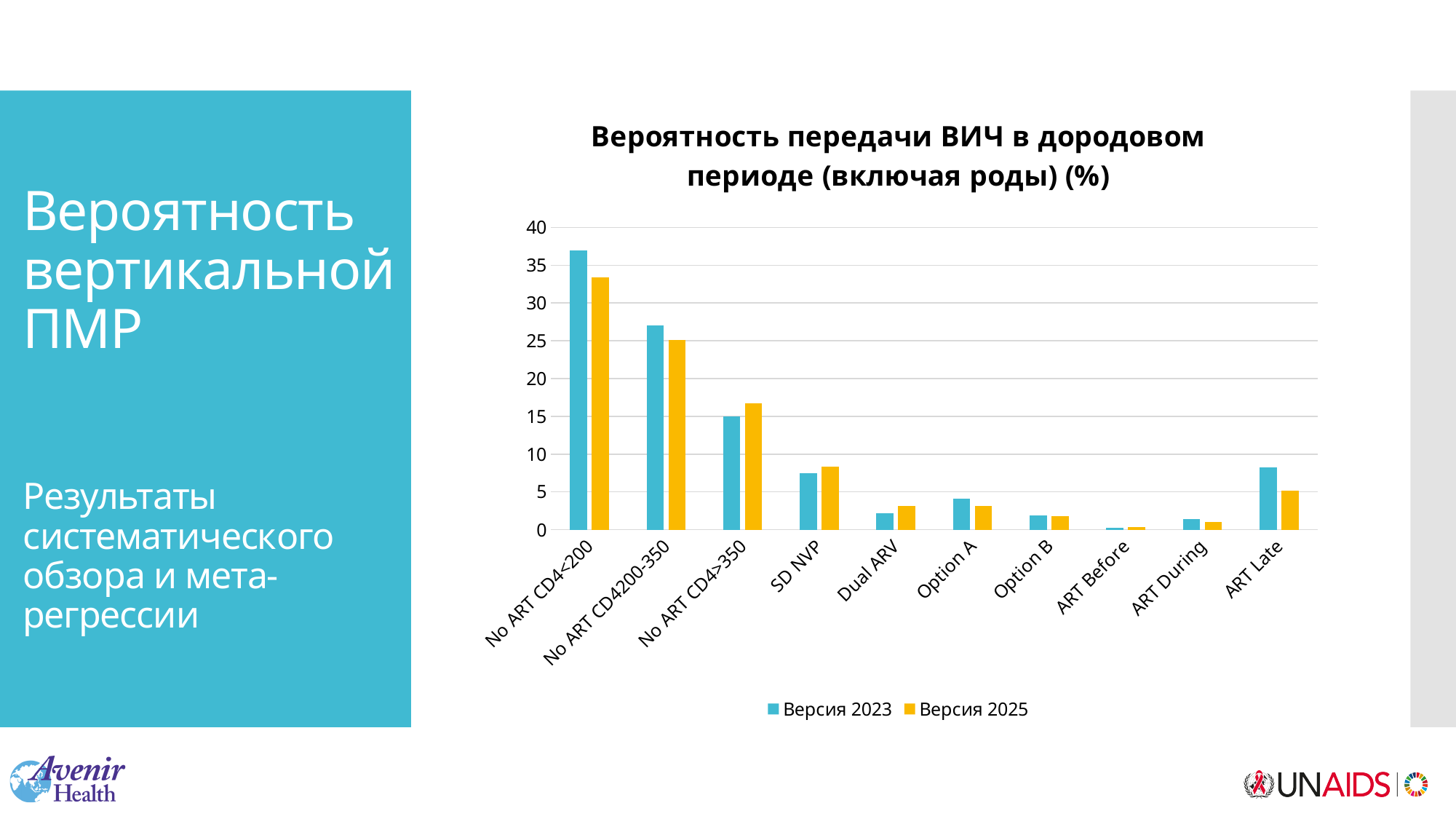
Which category has the highest value for Версия 2023? No ART CD4<200 What are the two series named in the chart legend? Версия 2023 and Версия 2025 What kind of chart is shown on the slide? bar chart For ART Late, which series has the larger value, Версия 2023 or Версия 2025? Версия 2023 For No ART CD4>350, which series has the larger value, Версия 2023 or Версия 2025? Версия 2025 How many series does the chart legend list? 2 Which category has the highest value for Версия 2025? No ART CD4<200 For No ART CD4<200, which series has the larger value, Версия 2023 or Версия 2025? Версия 2023 How many categories are shown on the x axis of the chart? 10 Is the Версия 2023 value for No ART CD4<200 greater or less than 35? greater Which category has the lowest value for Версия 2023? ART Before Is the Версия 2023 value for ART Late greater or less than 10? less